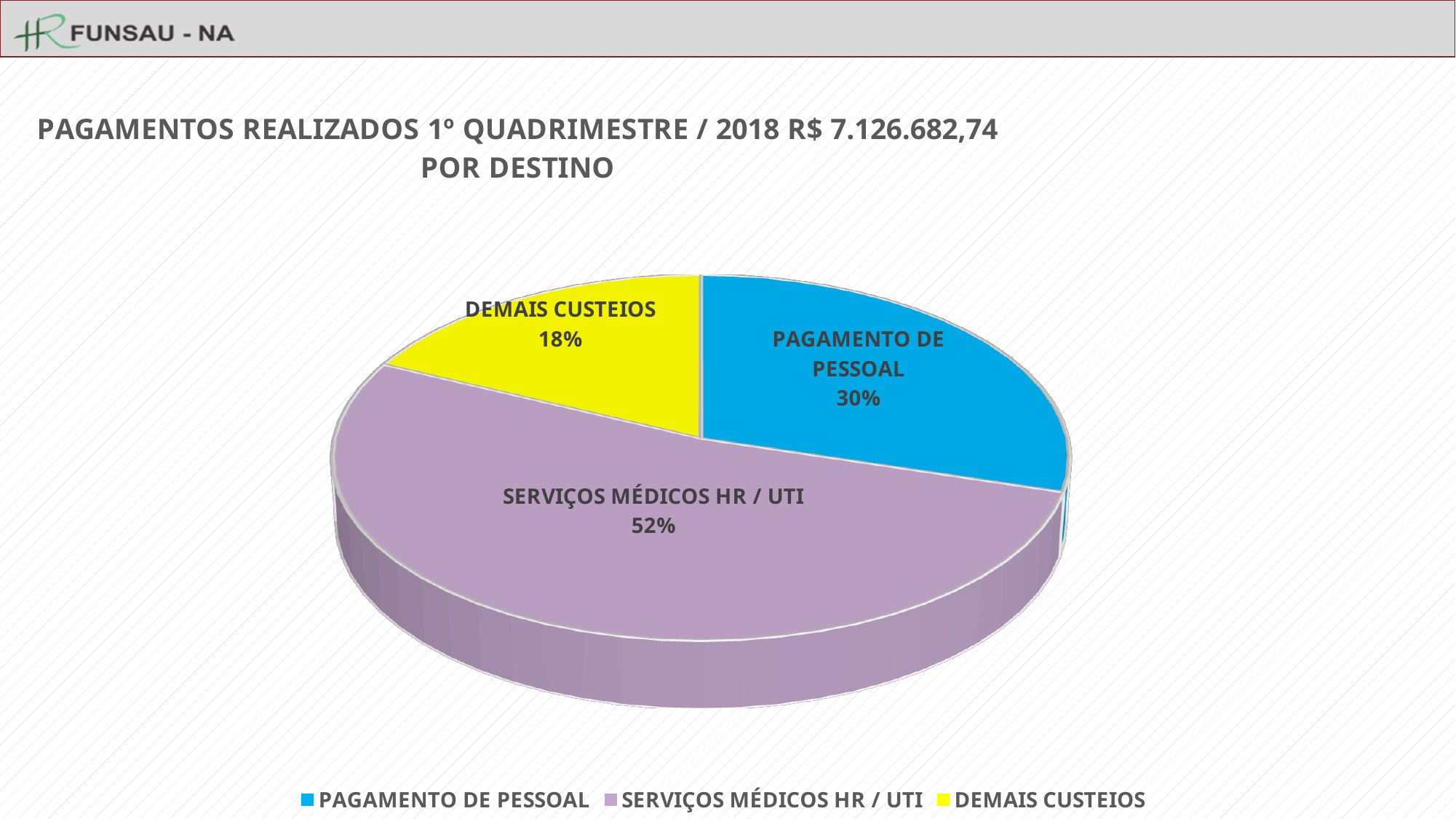
What share of the pie does DEMAIS CUSTEIOS represent? 18% How many categories are shown in the pie chart? 3 Which is larger, the share for PAGAMENTO DE PESSOAL or the share for DEMAIS CUSTEIOS? PAGAMENTO DE PESSOAL What is the total amount of payments stated in the chart title? R$ 7.126.682,74 What is the difference in percentage points between PAGAMENTO DE PESSOAL and DEMAIS CUSTEIOS? 12 percentage points Which category has the smallest slice of the pie? DEMAIS CUSTEIOS What share of the pie does PAGAMENTO DE PESSOAL represent? 30% What is the difference in percentage points between SERVIÇOS MÉDICOS HR / UTI and PAGAMENTO DE PESSOAL? 22 percentage points What kind of chart is shown on the slide? Pie chart Which category has the largest slice of the pie? SERVIÇOS MÉDICOS HR / UTI What colour is the slice for DEMAIS CUSTEIOS? Yellow What share of the pie does SERVIÇOS MÉDICOS HR / UTI represent? 52%